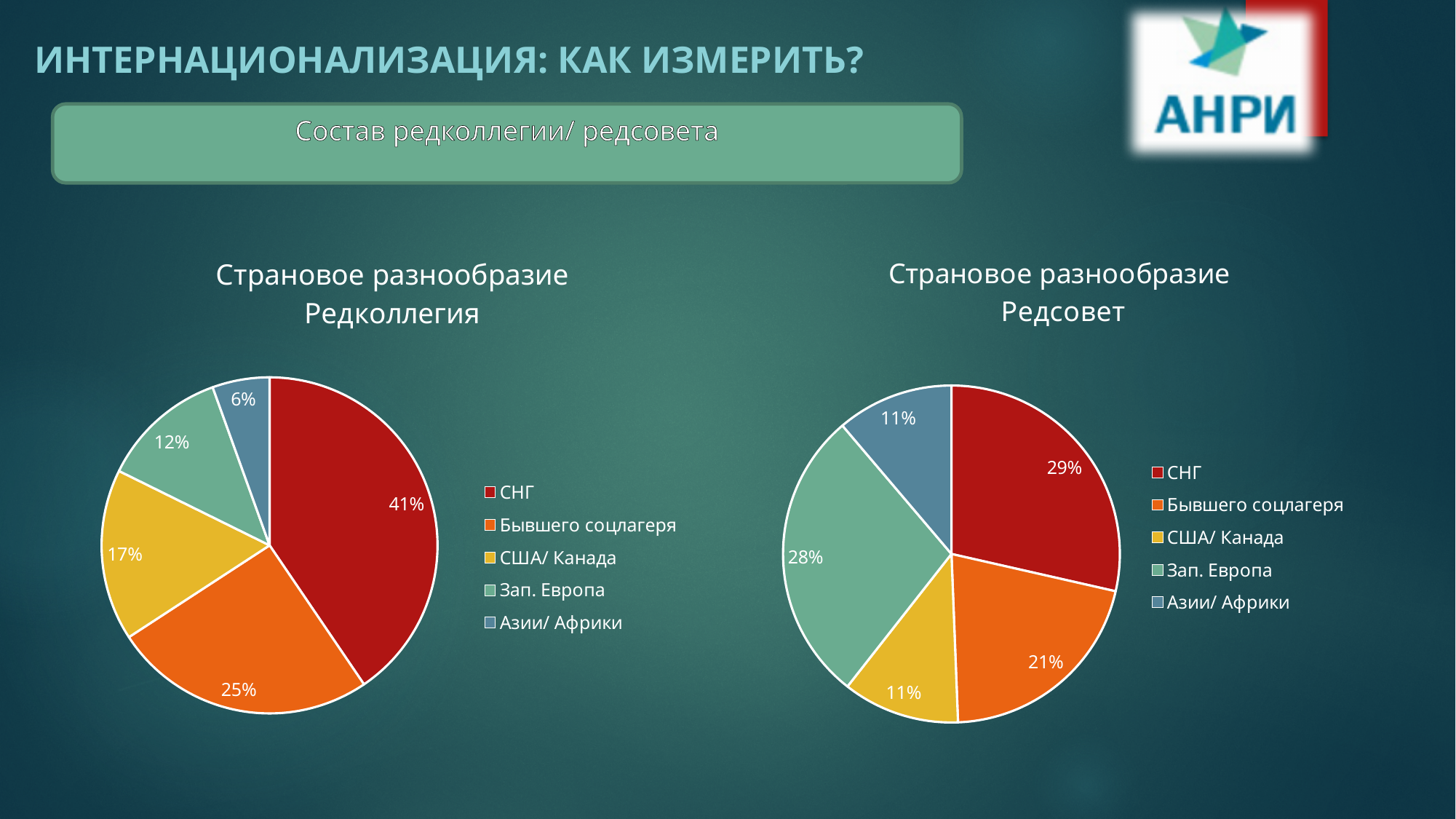
In the chart titled "Страновое разнообразие Редсовет", which is larger: Зап. Европа or Азии/ Африки? Зап. Европа In the chart titled "Страновое разнообразие Редсовет", what colour is the slice for Бывшего соцлагеря? Orange In the chart titled "Страновое разнообразие Редколлегия", which is larger: США/ Канада or Зап. Европа? США/ Канада In the chart titled "Страновое разнообразие Редсовет", what share does Зап. Европа have? 28% In the chart titled "Страновое разнообразие Редколлегия", which category has the largest slice? СНГ In the chart titled "Страновое разнообразие Редсовет", what is the difference between the shares of Бывшего соцлагеря and США/ Канада? 10% How many slices does the chart titled "Страновое разнообразие Редколлегия" have? 5 In the chart titled "Страновое разнообразие Редколлегия", what share does СНГ have? 41% In the chart titled "Страновое разнообразие Редсовет", which category has the largest slice? СНГ In the chart titled "Страновое разнообразие Редколлегия", which category has the smallest slice? Азии/ Африки In the chart titled "Страновое разнообразие Редколлегия", what is the difference between the shares of СНГ and Бывшего соцлагеря? 16% What type of chart is the chart titled "Страновое разнообразие Редсовет"? Pie chart